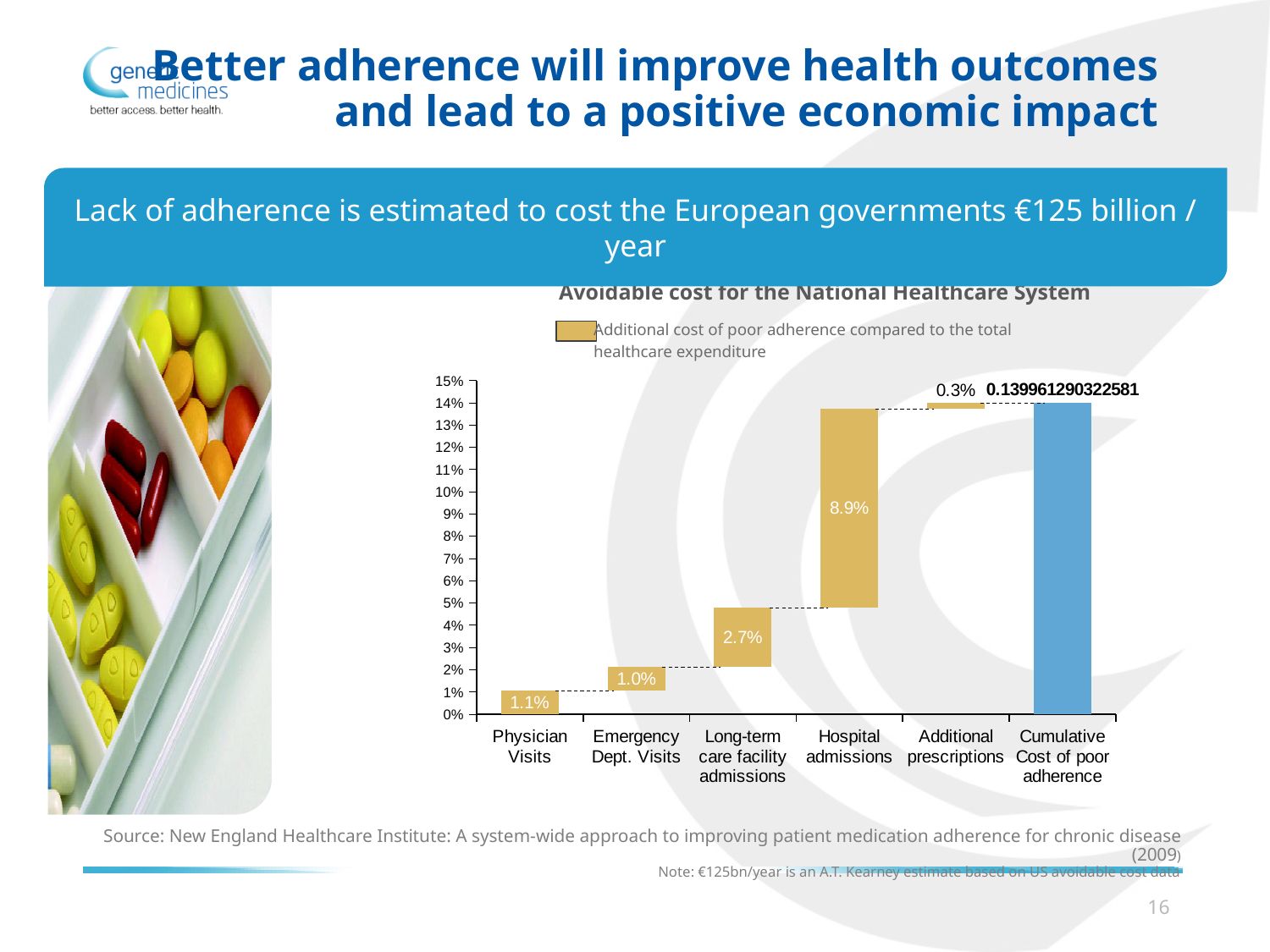
What data label is printed above the Cumulative Cost of poor adherence bar? 0.139961290322581 How many categories are shown on the x axis? 6 What is the value shown for Hospital admissions? 8.9% What is the value shown for Additional prescriptions? 0.3% What is the value shown for Physician Visits? 1.1% What is the value shown for Long-term care facility admissions? 2.7% What is the title of the chart? Avoidable cost for the National Healthcare System Is the top of the Cumulative Cost of poor adherence bar greater or less than 10%? greater What is the difference between the values for Hospital admissions and Long-term care facility admissions? 6.2% Which is larger, the value for Physician Visits or the value for Emergency Dept. Visits? Physician Visits Which category has the lowest value? Additional prescriptions Which category has the highest value among the tan-coloured bars? Hospital admissions